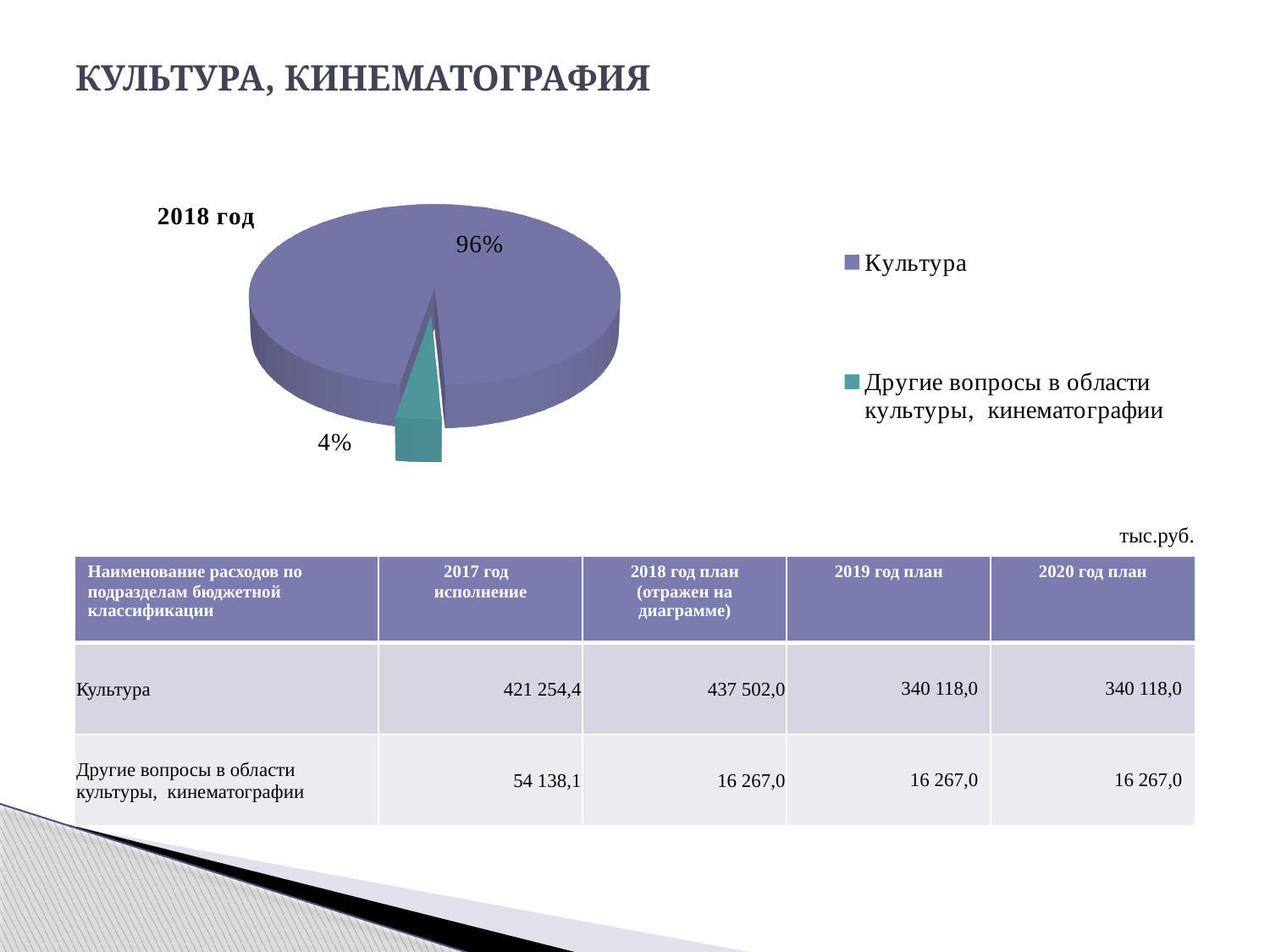
What kind of chart is shown on the slide? Pie chart Which slice of the pie is the smallest? Другие вопросы в области культуры, кинематографии How many slices does the pie chart have? 2 According to the table, what 2018 plan value for Культура is reflected in the pie chart? 437 502,0 Which year does the pie chart represent, according to its title? 2018 год What colour is the Культура slice in the pie chart? Purple Which is larger in the pie chart: Культура or Другие вопросы в области культуры, кинематографии? Культура What share of the pie does Культура have? 96% How many entries does the legend list? 2 What is the difference in percentage points between the Культура slice and the Другие вопросы в области культуры, кинематографии slice? 92 What share of the pie does Другие вопросы в области культуры, кинематографии have? 4% Which slice of the pie is the largest? Культура